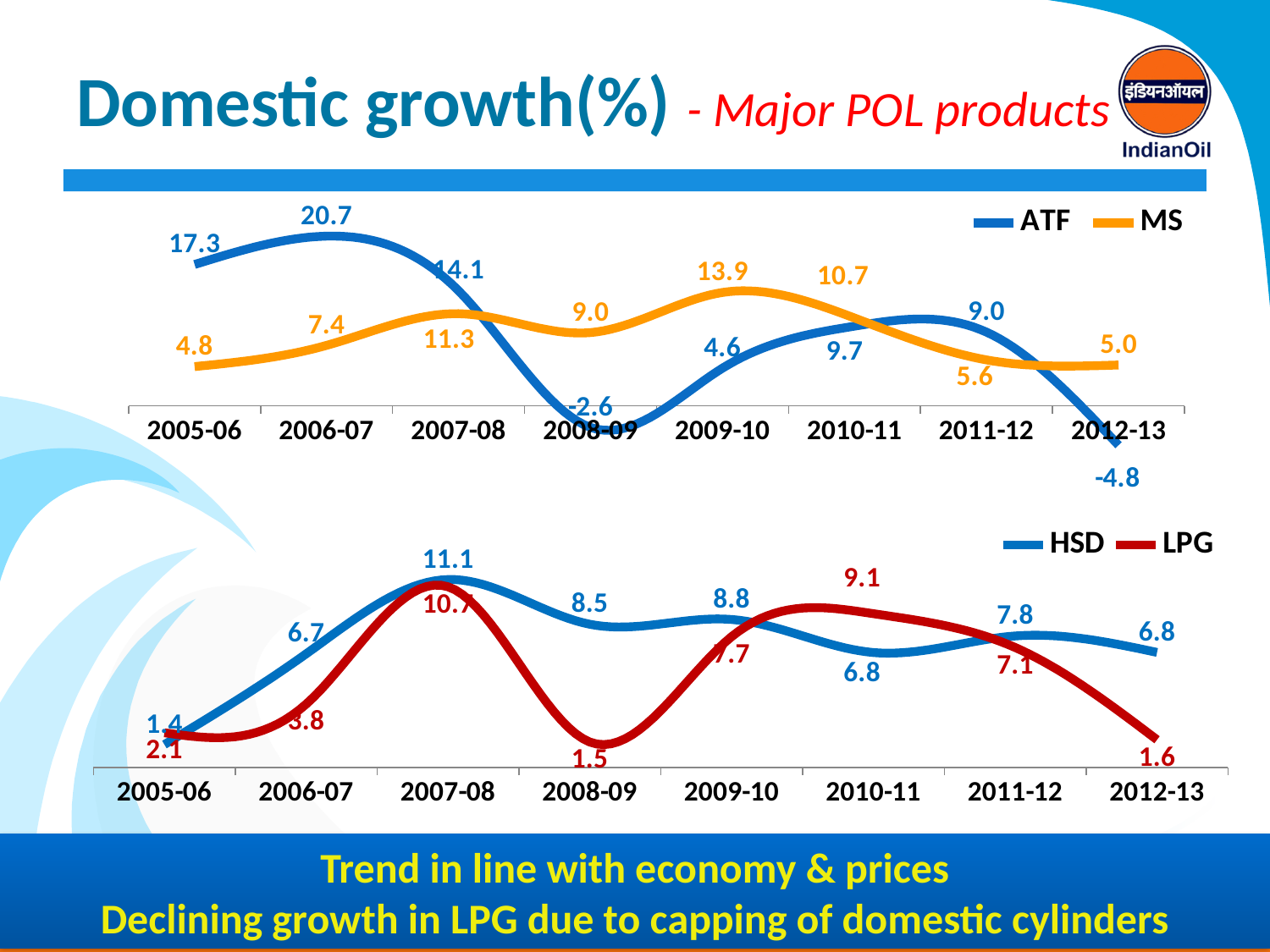
In the top chart (ATF and MS), which is larger in 2005-06, ATF or MS? ATF In the top chart (ATF and MS), what is the ATF value for 2006-07? 20.7 How many series does the legend of the top chart (ATF and MS) list? 2 In the bottom chart (HSD and LPG), in which year is the LPG value lowest? 2008-09 How many years are shown on the x axis of the bottom chart (HSD and LPG)? 8 In the top chart (ATF and MS), in which year is the ATF value highest? 2006-07 In the top chart (ATF and MS), what is the MS value for 2009-10? 13.9 In the bottom chart (HSD and LPG), what is the difference between the HSD values for 2007-08 and 2012-13? 4.3 In the bottom chart (HSD and LPG), what is the LPG value for 2010-11? 9.1 In the bottom chart (HSD and LPG), what is the HSD value for 2007-08? 11.1 What kind of chart is the top chart (ATF and MS)? Line chart In the top chart (ATF and MS), in which year is the ATF value lowest? 2012-13